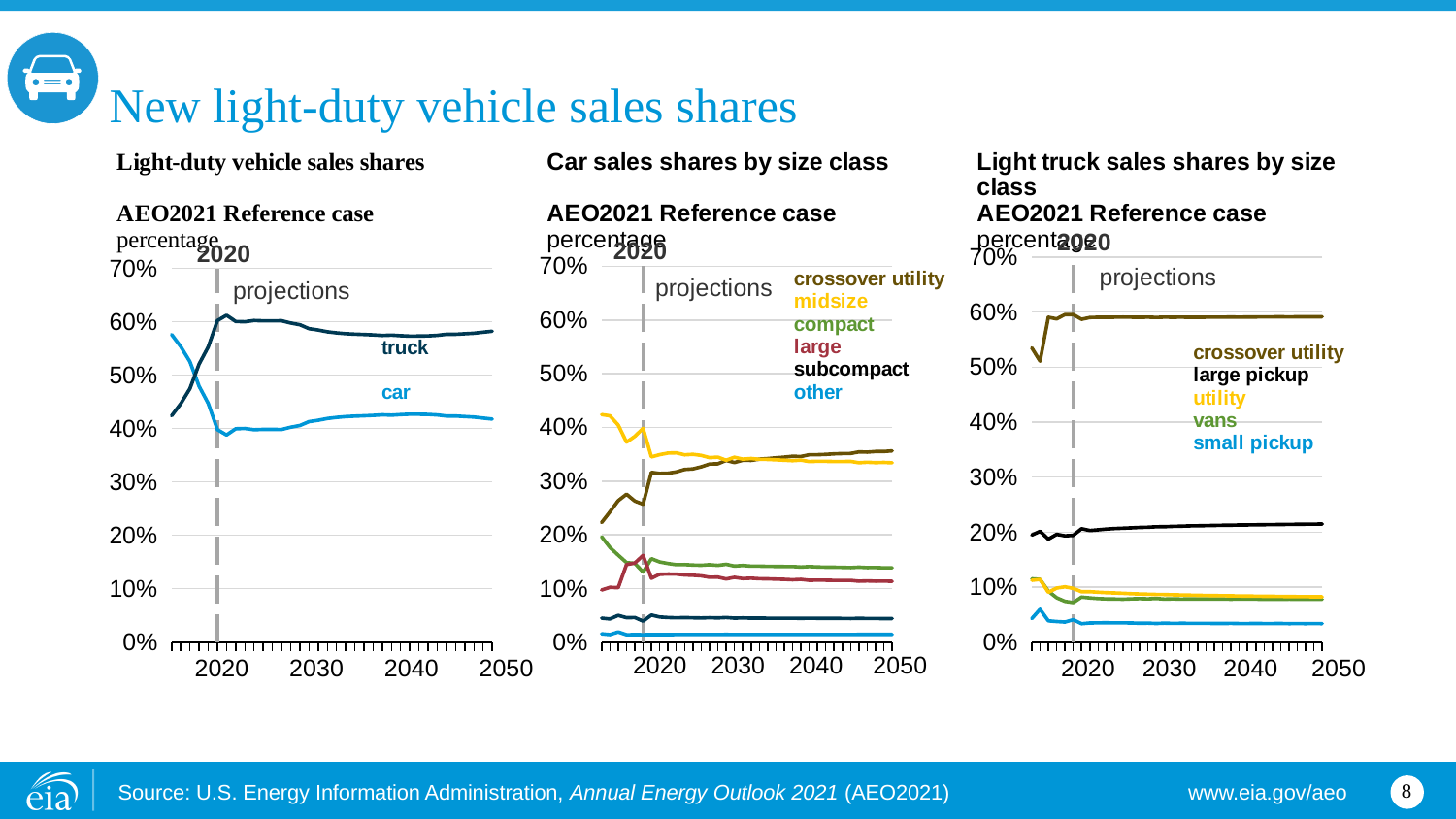
In the 'Car sales shares by size class' chart, how many size classes are listed in the legend? 6 In the 'Light truck sales shares by size class' chart, which series has the highest value in 2050? crossover utility In the 'Light-duty vehicle sales shares' chart, how many series are plotted? 2 In the 'Car sales shares by size class' chart, is the value for crossover utility in 2050 greater or less than 30%? greater In the 'Car sales shares by size class' chart, does the crossover utility share rise or fall over the projection period? rise In the 'Light-duty vehicle sales shares' chart, is the value for car in 2050 greater or less than 50%? less In the 'Light truck sales shares by size class' chart, is the value for large pickup in 2050 greater or less than 10%? greater What kind of chart is the 'Light-duty vehicle sales shares' chart? line chart In the 'Light-duty vehicle sales shares' chart, which series has the higher value in 2050, truck or car? truck What year does the dashed vertical line in each chart mark as the start of projections? 2020 In the 'Light-duty vehicle sales shares' chart, does the truck share rise or fall between 2015 and 2020? rise In the 'Car sales shares by size class' chart, which series has the lowest value in 2050? other